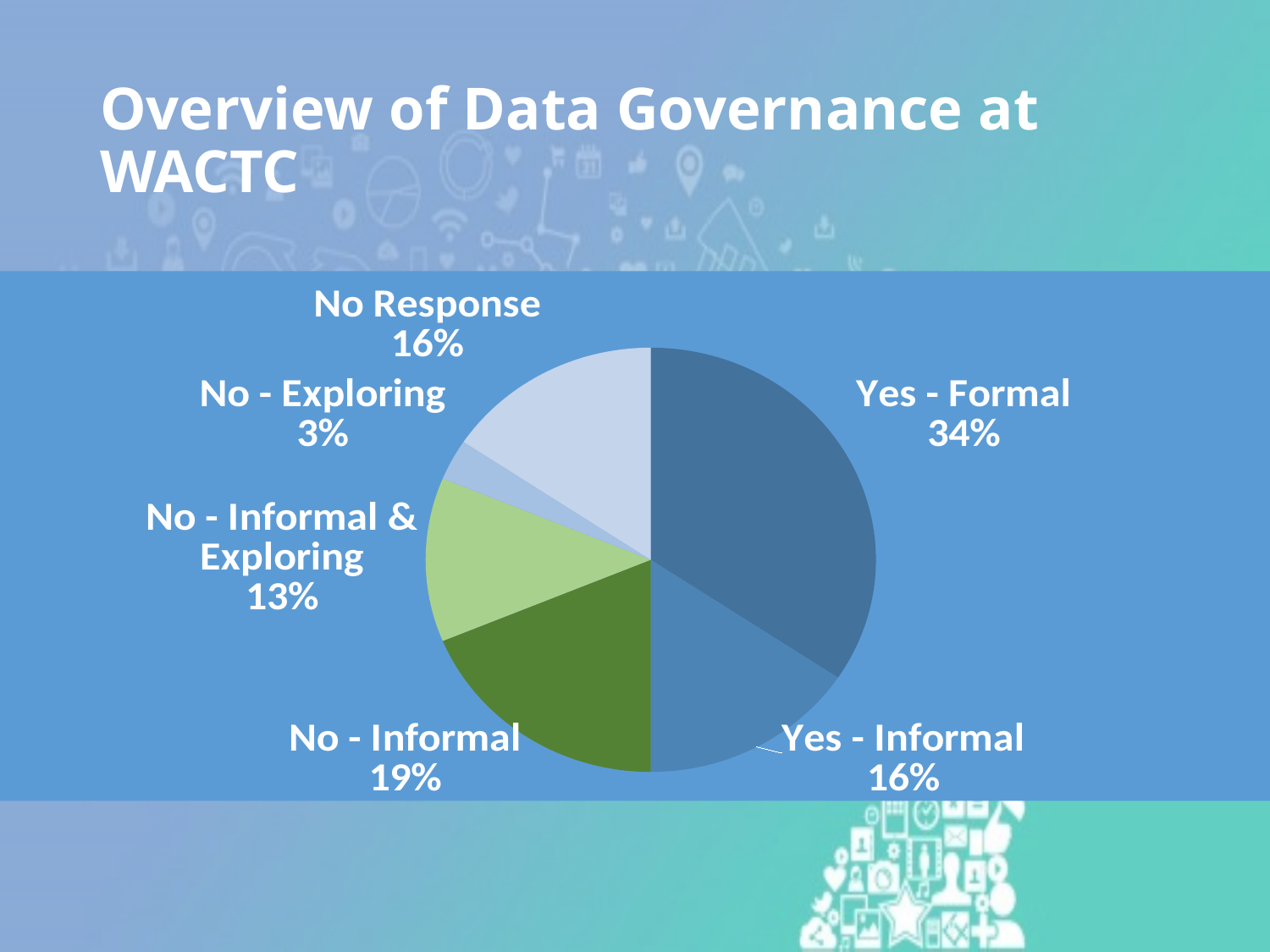
What percentage is shown for No - Exploring? 3% How many slices does the pie chart have? 6 What percentage is shown for No Response? 16% What percentage is shown for No - Informal & Exploring? 13% What kind of chart is shown on the slide? pie chart What percentage is shown for No - Informal? 19% What is the difference in percentage points between Yes - Formal and No - Informal? 15 Which category has the smallest slice of the pie? No - Exploring What is the title of the slide containing the pie chart? Overview of Data Governance at WACTC What share of the pie is labelled Yes - Formal? 34% Which category has the largest slice of the pie? Yes - Formal Which is larger, No - Informal or No - Informal & Exploring? No - Informal